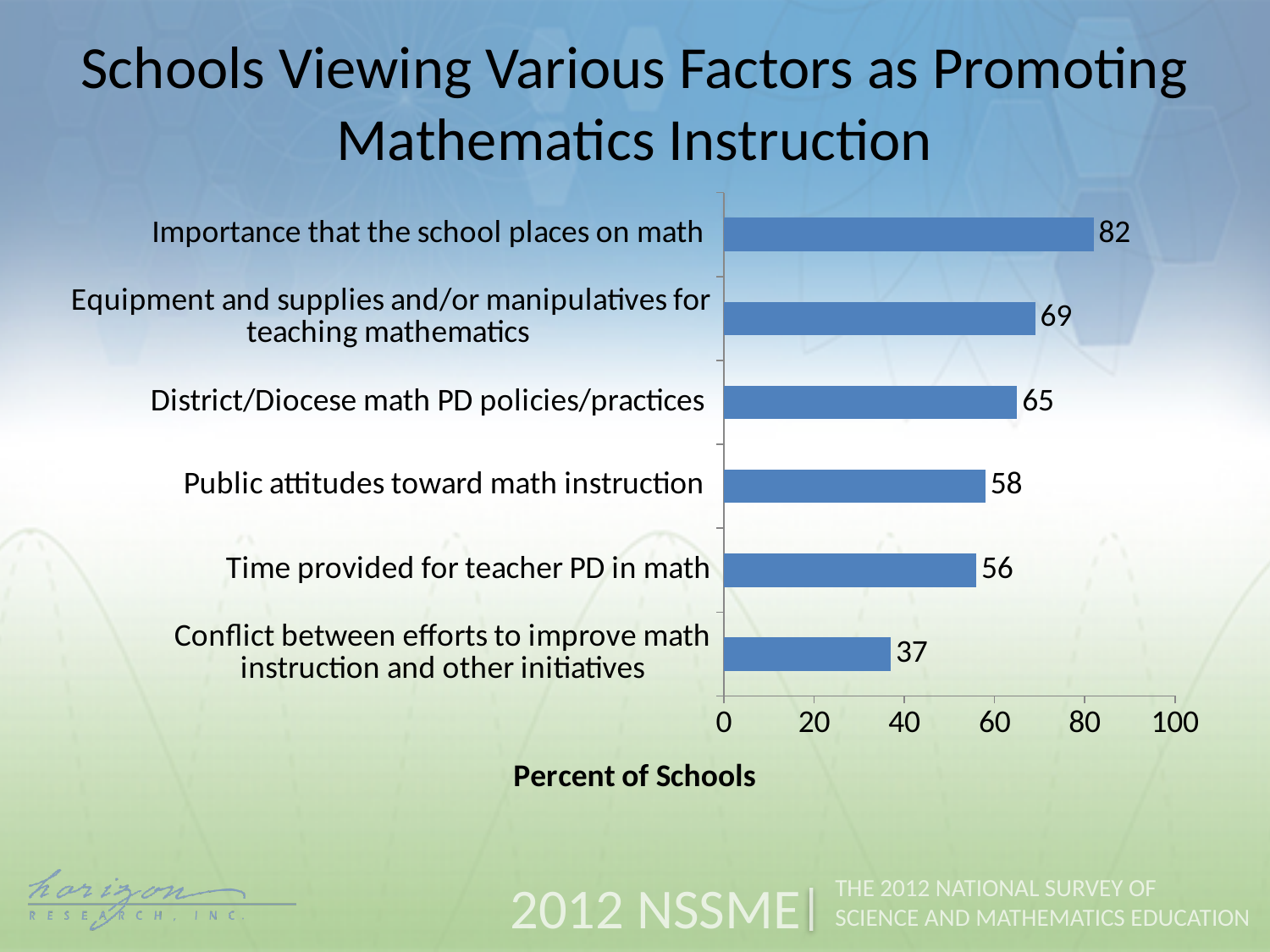
Which factor has the lowest percent of schools? Conflict between efforts to improve math instruction and other initiatives How many factors are shown on the chart? 6 What is the value for 'Conflict between efforts to improve math instruction and other initiatives'? 37 What is the value for 'Time provided for teacher PD in math'? 56 Which factor has the highest percent of schools? Importance that the school places on math What kind of chart is shown on the slide? Bar chart What is the difference between the values for 'Equipment and supplies and/or manipulatives for teaching mathematics' and 'District/Diocese math PD policies/practices'? 4 What percent of schools view the importance that the school places on math as promoting mathematics instruction? 82 Which is larger: the value for 'Public attitudes toward math instruction' or 'Time provided for teacher PD in math'? Public attitudes toward math instruction What is the label of the horizontal axis? Percent of Schools What is the difference between the highest and lowest values on the chart? 45 Is the value for 'District/Diocese math PD policies/practices' greater or less than 60? greater